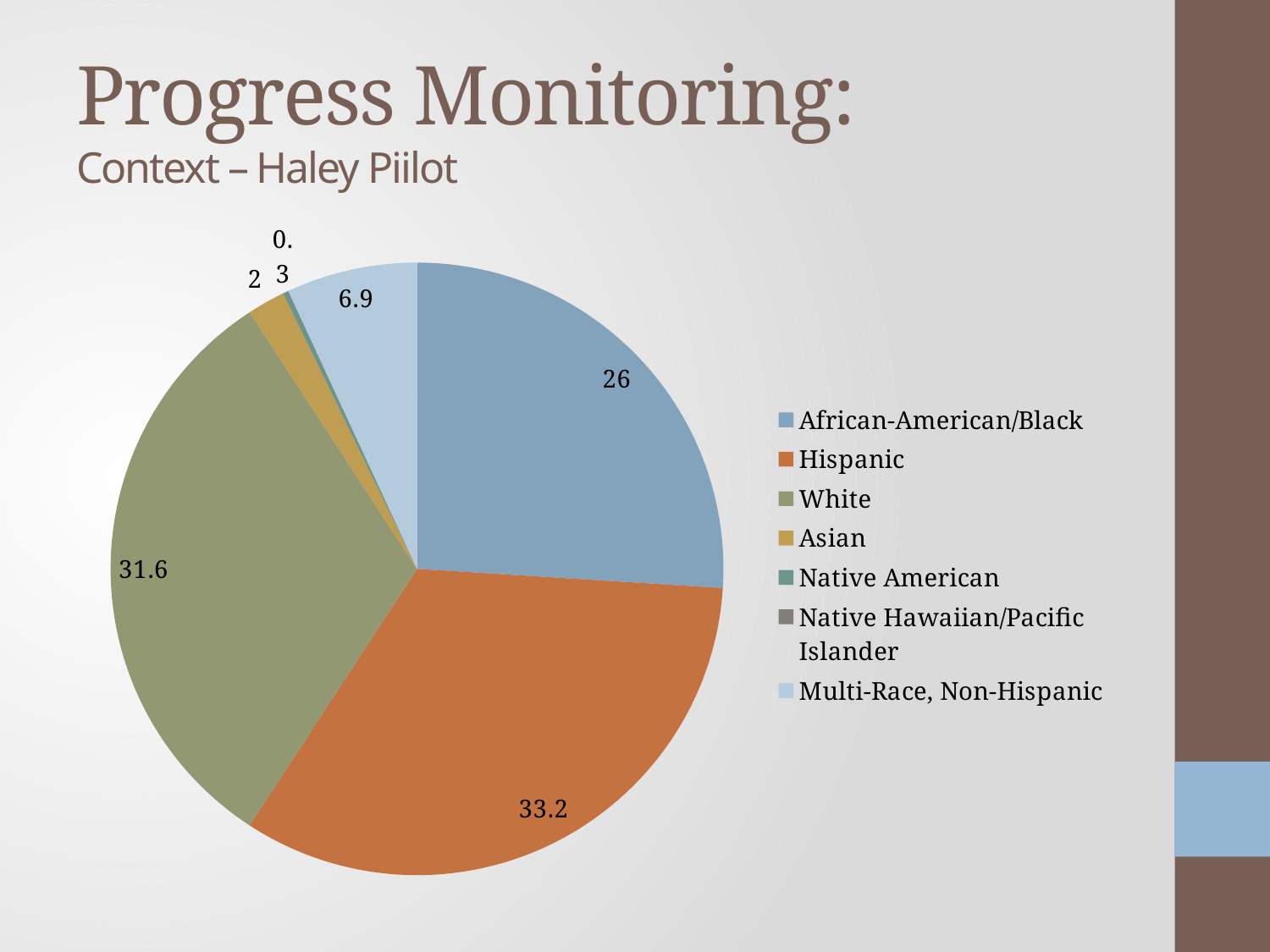
How many categories does the legend list? 7 What is the value shown for White? 31.6 What is the value shown for Hispanic? 33.2 What is the value shown for African-American/Black? 26 Which is larger, the value for Hispanic or the value for White? Hispanic Which category has the largest slice of the pie? Hispanic What is the difference between the values for African-American/Black and Multi-Race, Non-Hispanic? 19.1 What is the value shown for Asian? 2 What is the difference between the values for Hispanic and White? 1.6 What colour is the Hispanic slice of the pie? orange What type of chart is shown on the slide? pie chart What is the value shown for Multi-Race, Non-Hispanic? 6.9